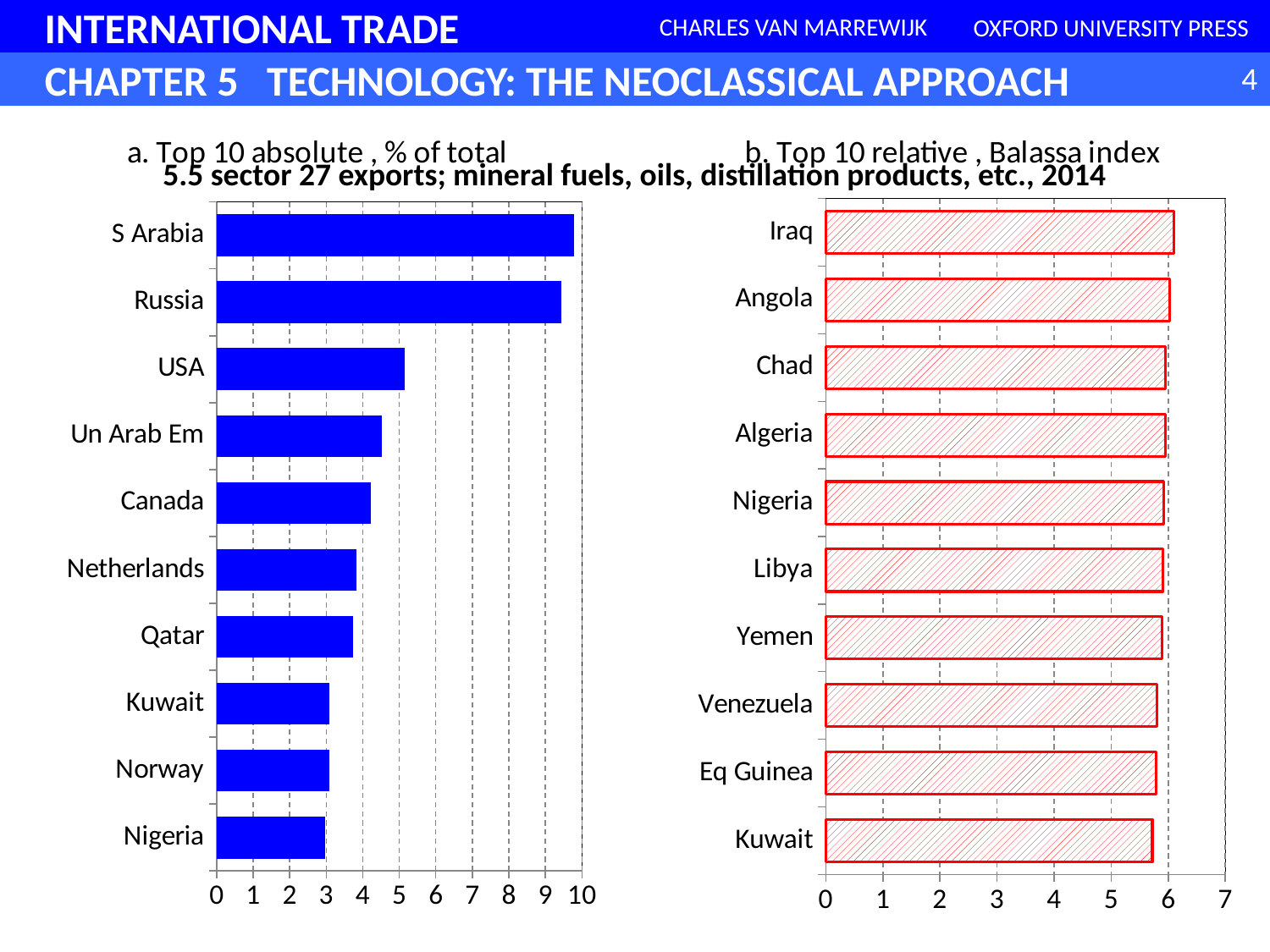
How many countries are shown in the left chart, 'a. Top 10 absolute, % of total'? 10 In the left chart, 'a. Top 10 absolute, % of total', is the value for Canada greater or less than 5? less In the left chart, 'a. Top 10 absolute, % of total', which country has the highest value? S Arabia What kind of chart is the left chart, 'a. Top 10 absolute, % of total'? bar chart In the left chart, 'a. Top 10 absolute, % of total', is the value for S Arabia greater or less than 9? greater In the right chart, 'b. Top 10 relative, Balassa index', is the value for Venezuela greater or less than 5? greater What is the overall title shown above the two charts? 5.5 sector 27 exports; mineral fuels, oils, distillation products, etc., 2014 In the left chart, 'a. Top 10 absolute, % of total', which is larger, the value for Russia or the value for USA? Russia How many countries are shown in the right chart, 'b. Top 10 relative, Balassa index'? 10 In the left chart, 'a. Top 10 absolute, % of total', which is larger, the value for Netherlands or the value for Kuwait? Netherlands